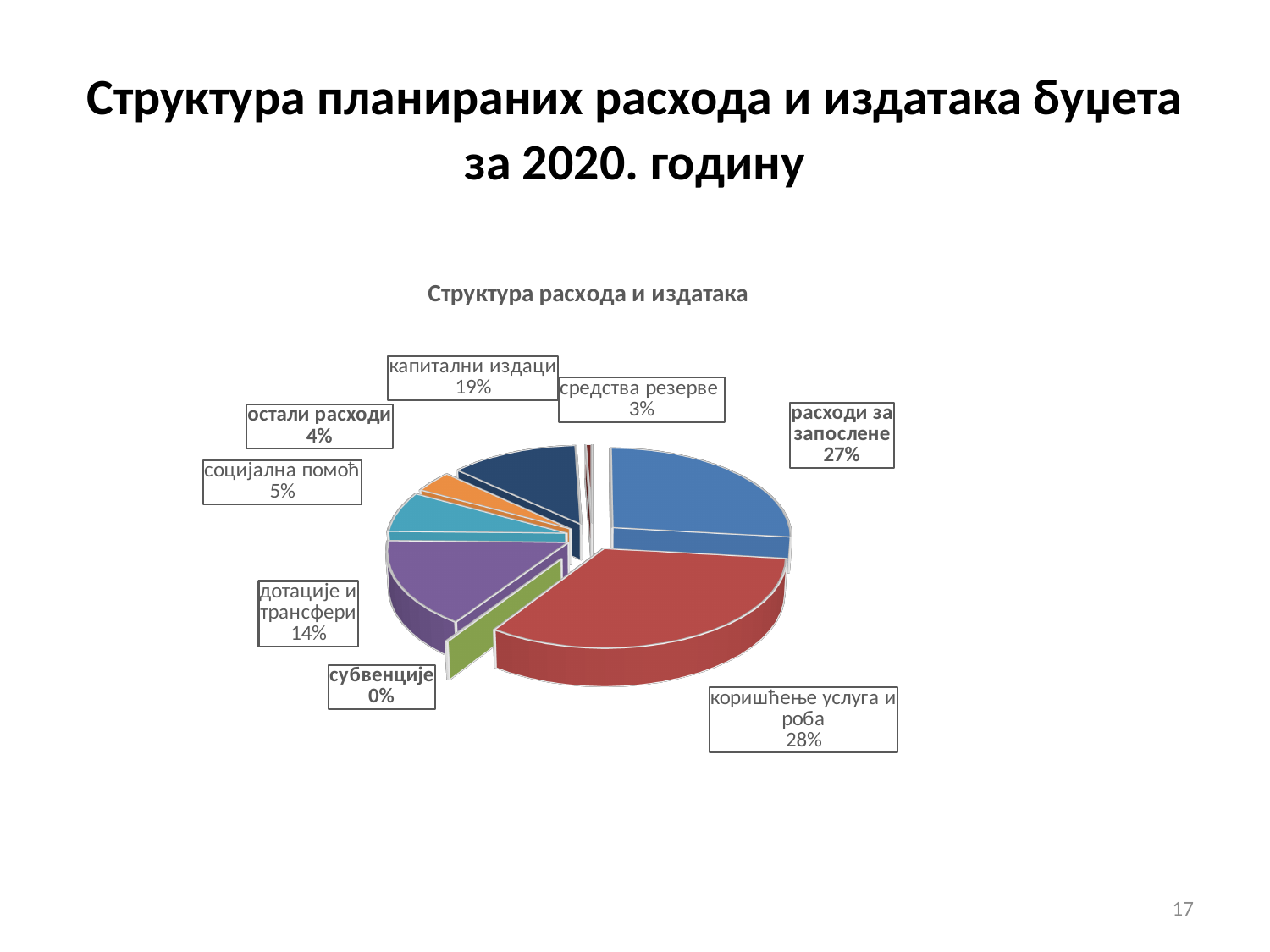
What share of the pie does "средства резерве" have? 3% What share of the pie does "капитални издаци" have? 19% Which has a larger share, "социјална помоћ" or "остали расходи"? социјална помоћ What share of the pie does "коришћење услуга и роба" have? 28% What is the title of the chart? Структура расхода и издатака Which category has the largest share of the pie? коришћење услуга и роба How many categories are shown in the pie chart? 8 What kind of chart is shown on the slide? pie chart Which category has the smallest share of the pie? субвенције What is the difference between the shares of "капитални издаци" and "дотације и трансфери"? 5%